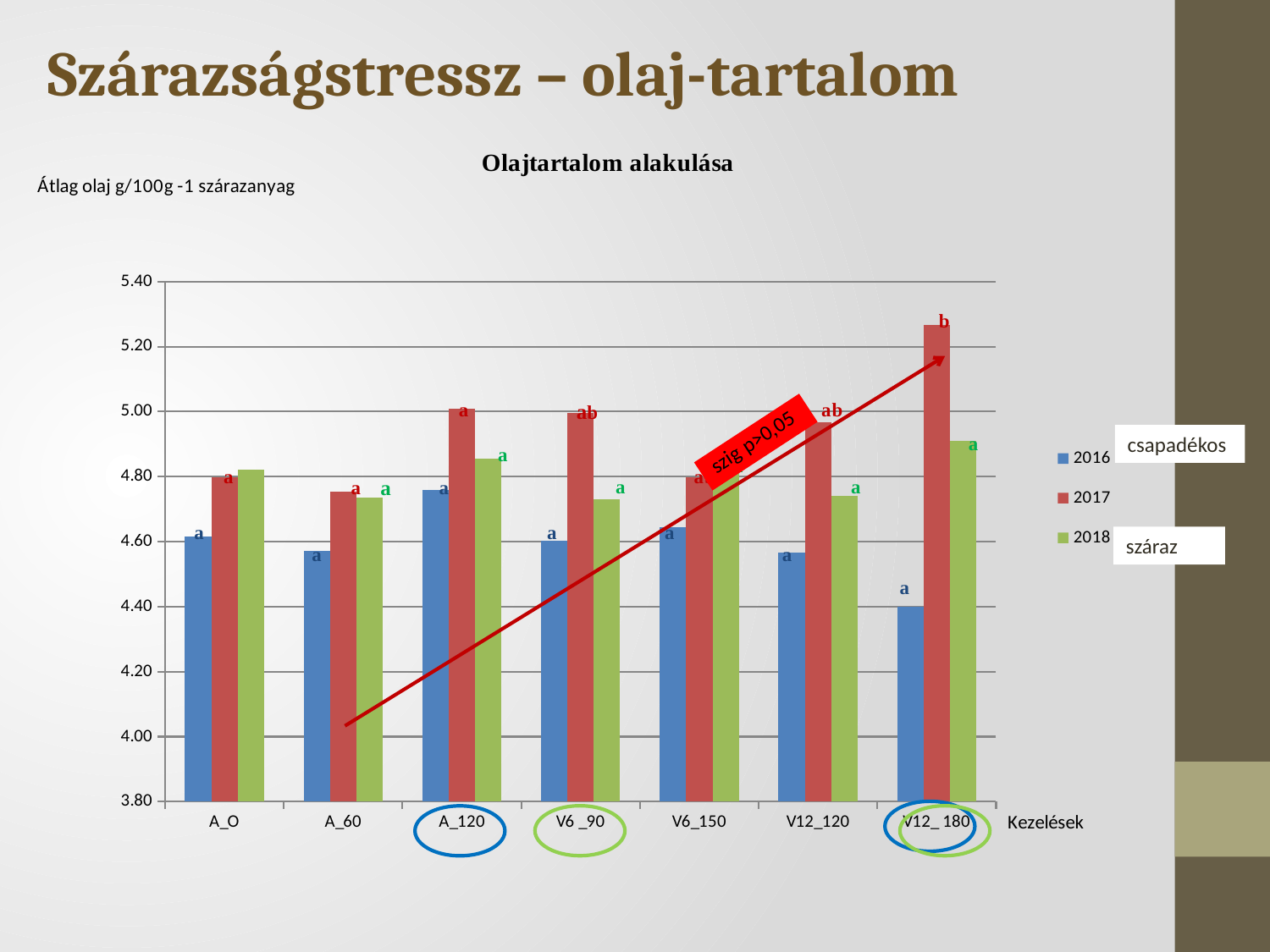
How many series does the chart's legend list? 3 For V12_180, which is larger: the 2016 value or the 2017 value? 2017 Is the 2017 value for V12_180 greater or less than 5.20? greater How many treatment categories are shown on the x axis of the chart? 7 Is the 2018 value for V6_90 greater or less than 4.80? less Which category has the lowest 2016 bar? V12_180 What is the title of the chart? Olajtartalom alakulása Is the 2018 value for V12_180 greater or less than 4.80? greater Which series and category has the highest bar in the chart? 2017, V12_180 What kind of chart is shown on the slide? bar chart Which category has the highest 2016 bar? A_120